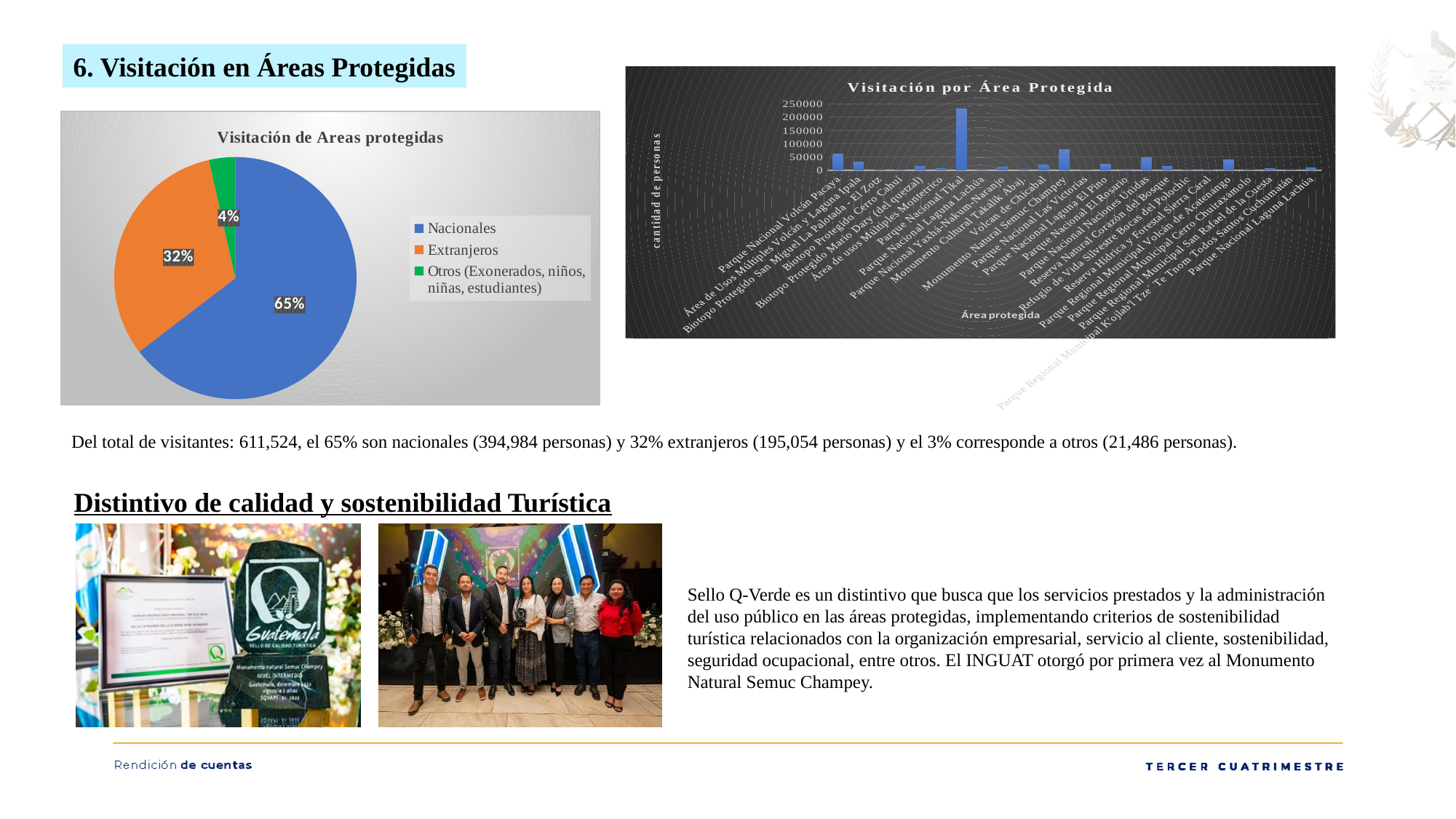
On the pie chart 'Visitación de Areas protegidas', which category has the smallest share? Otros (Exonerados, niños, niñas, estudiantes) On the pie chart 'Visitación de Areas protegidas', what percentage is shown for Extranjeros? 32% On the bar chart 'Visitación por Área Protegida', is the value for Parque Nacional Tikal greater or less than 200000? greater How many categories does the legend of the pie chart 'Visitación de Areas protegidas' list? 3 What kind of chart is the chart on the right titled 'Visitación por Área Protegida'? Bar chart On the pie chart 'Visitación de Areas protegidas', which category has the largest share? Nacionales On the pie chart 'Visitación de Areas protegidas', how many percentage points larger is Nacionales than Extranjeros? 33 percentage points On the pie chart 'Visitación de Areas protegidas', what percentage is shown for Nacionales? 65% On the pie chart 'Visitación de Areas protegidas', what percentage is shown for Otros (Exonerados, niños, niñas, estudiantes)? 4% What kind of chart is the chart on the left titled 'Visitación de Areas protegidas'? Pie chart On the pie chart 'Visitación de Areas protegidas', which is larger: Extranjeros or Otros? Extranjeros On the bar chart 'Visitación por Área Protegida', which protected area has the highest visitation? Parque Nacional Tikal